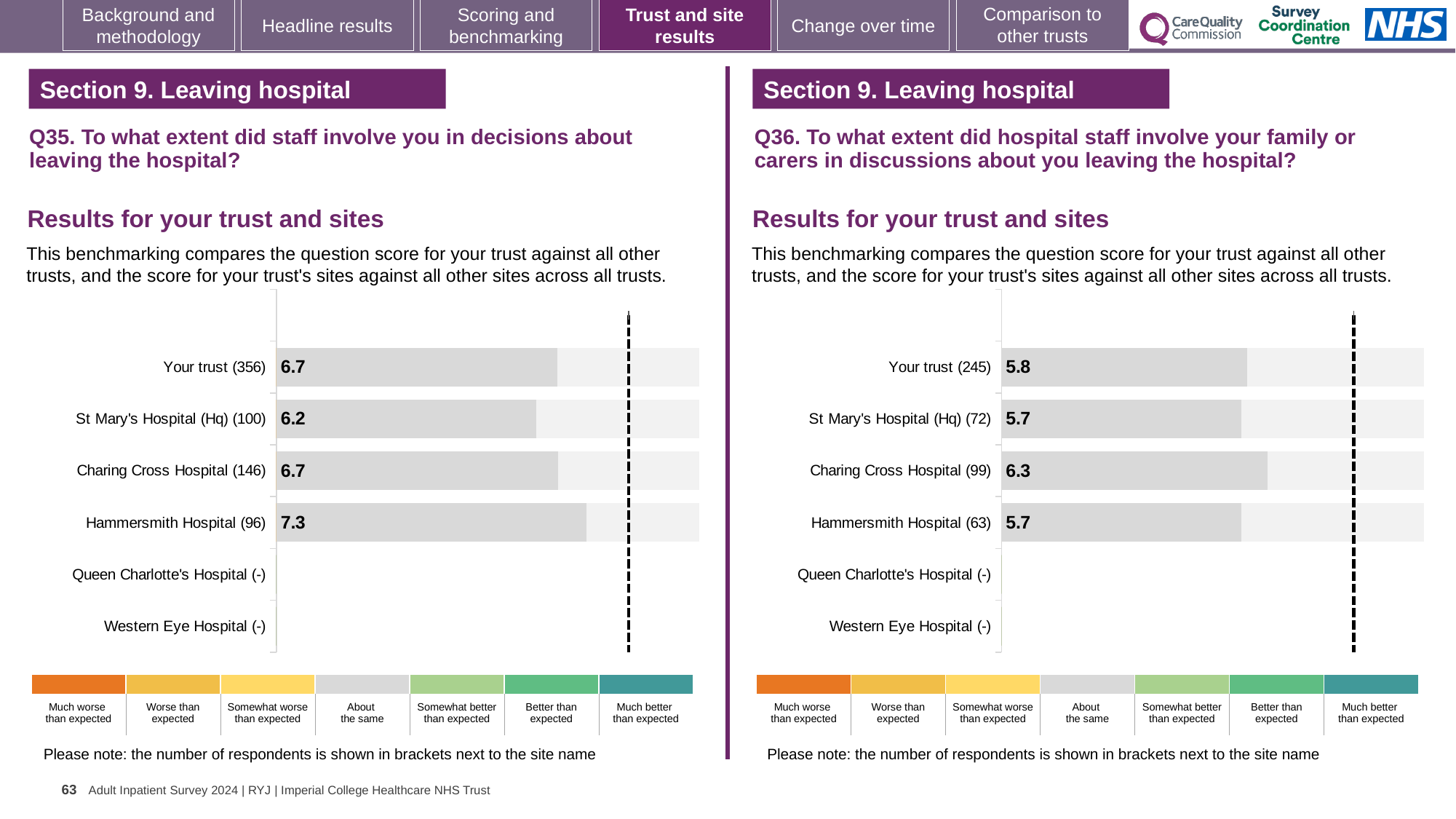
In the Q36 chart on the right, which site has the highest score? Charing Cross Hospital In the Q35 chart on the left, what is the score for Hammersmith Hospital? 7.3 In the Q35 chart on the left, which site has the lowest score among those with a bar shown? St Mary's Hospital (Hq) In the Q36 chart on the right, what is the difference between the scores for Charing Cross Hospital and Hammersmith Hospital? 0.6 In the Q35 chart on the left, what is the score for St Mary's Hospital (Hq)? 6.2 In the Q36 chart on the right, is the score for Charing Cross Hospital larger or smaller than the score for Your trust? larger In the Q36 chart on the right, what is the score for Charing Cross Hospital? 6.3 In the Q35 chart on the left, how many sites (including Your trust) have a bar with a score plotted? 4 In the Q35 chart on the left, which site has the highest score? Hammersmith Hospital What type of chart is used on the left for Q35? Bar chart In the Q35 chart on the left, what is the difference between the scores for Hammersmith Hospital and St Mary's Hospital (Hq)? 1.1 In the Q36 chart on the right, what is the score for Your trust? 5.8